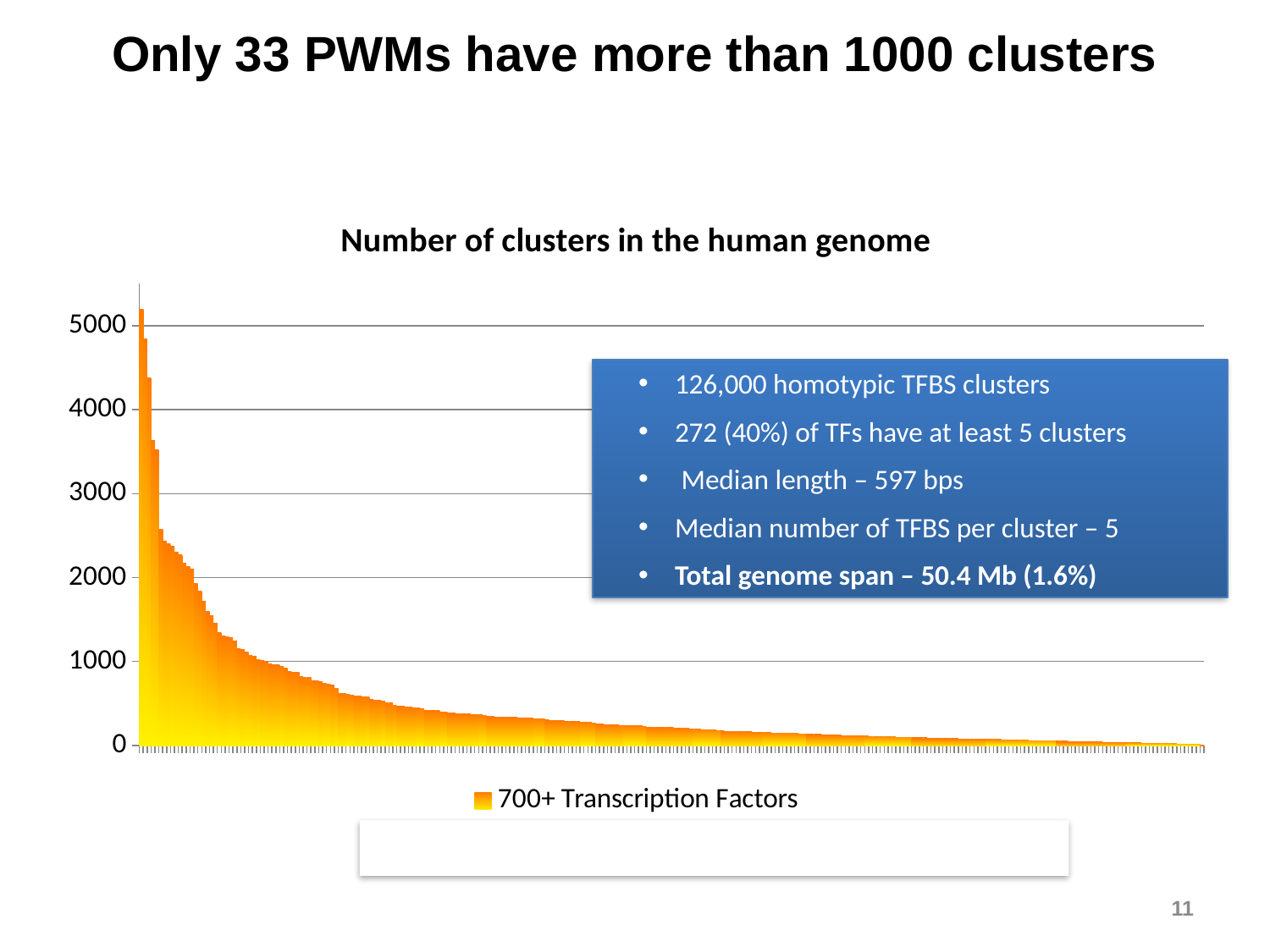
What is the legend entry for the series in the chart? 700+ Transcription Factors How many series does the chart legend list? 1 Do the bar values rise or fall moving from left to right along the x axis? fall Is the value of the bar at the far right end of the chart greater or less than 500? less Is the value of the rightmost bar greater or less than 1000? less Is the value of the tallest bar (leftmost) greater or less than 4000? greater What kind of chart is shown on the slide? bar chart What is the title of the chart? Number of clusters in the human genome What is the highest tick value shown on the y axis? 5000